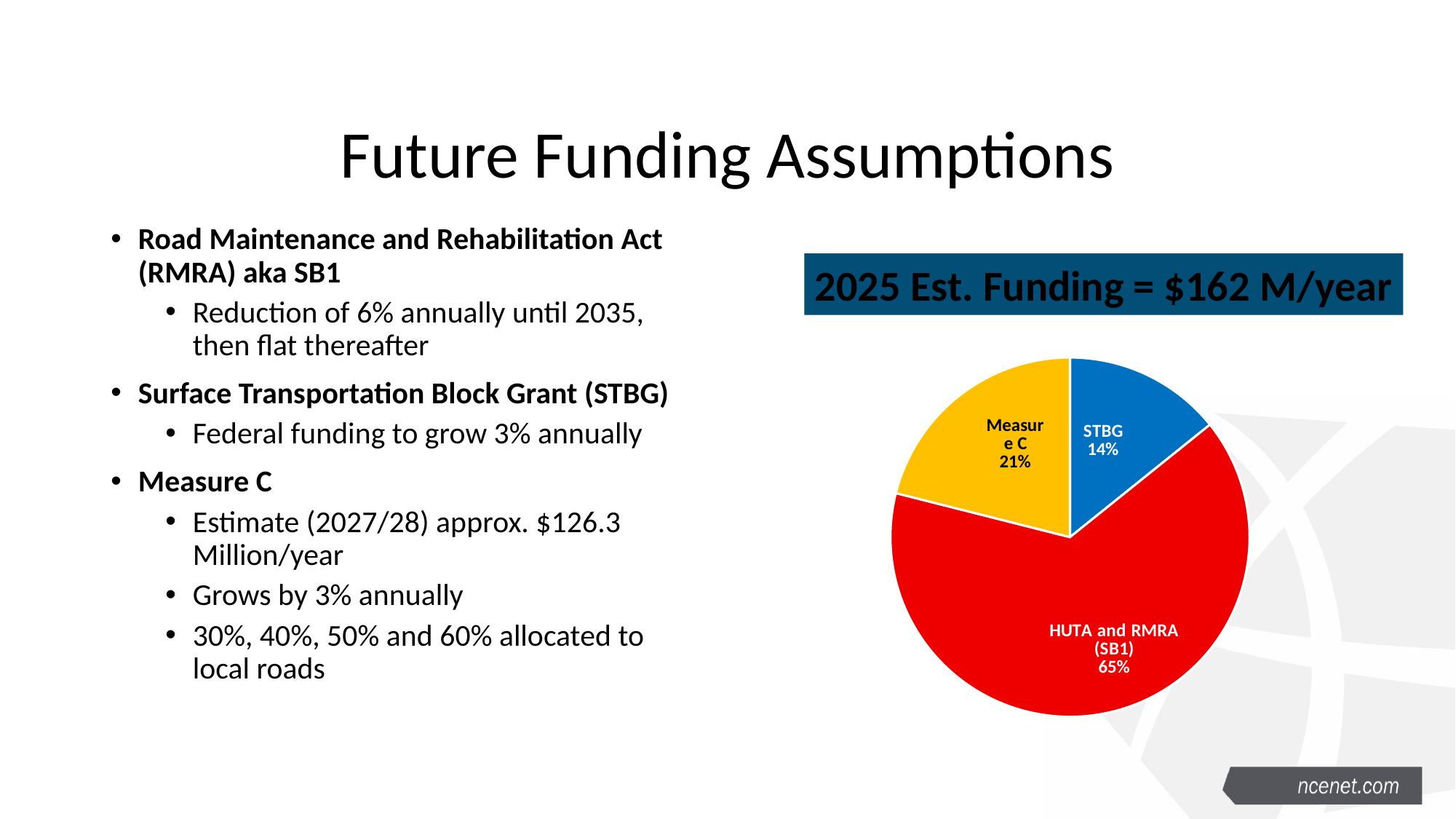
Which is larger, the Measure C slice or the STBG slice? Measure C How many slices does the pie chart have? 3 What is the 2025 estimated funding stated above the pie chart? $162 M/year Which slice of the pie is the smallest? STBG What share of the pie does STBG represent? 14% What kind of chart is shown on the slide? Pie chart What share of the pie does HUTA and RMRA (SB1) represent? 65% What is the difference in percentage points between the Measure C slice and the STBG slice? 7% Which slice of the pie is the largest? HUTA and RMRA (SB1) What colour is the HUTA and RMRA (SB1) slice? Red What share of the pie does Measure C represent? 21% What is the difference in percentage points between the HUTA and RMRA (SB1) slice and the Measure C slice? 44%